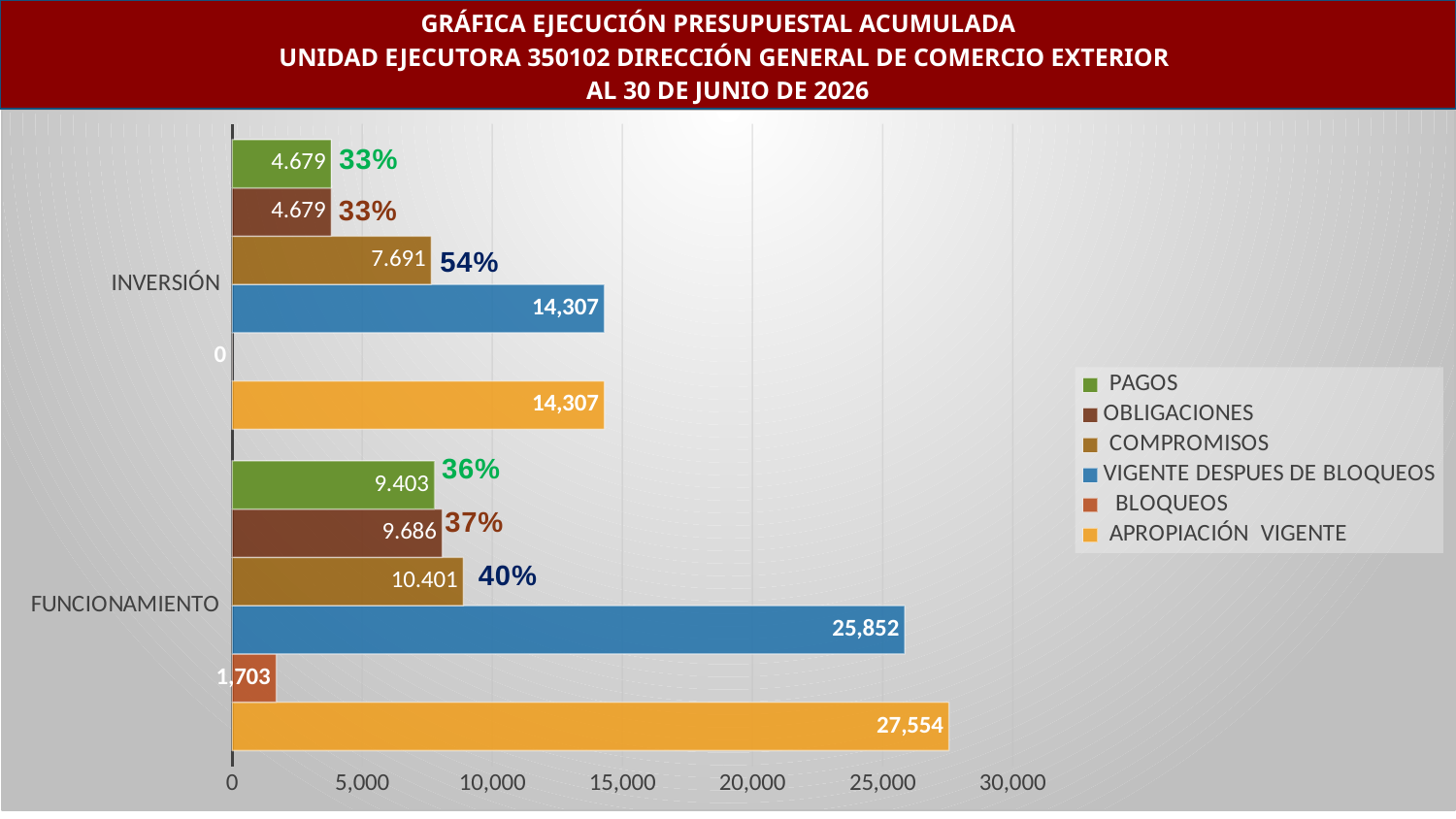
What is the value of COMPROMISOS for FUNCIONAMIENTO? 10.401 What kind of chart is shown on the slide? Bar chart How many series does the legend list? 6 Which series has the highest value for FUNCIONAMIENTO? APROPIACIÓN VIGENTE What is the value of BLOQUEOS for INVERSIÓN? 0 What percentage is shown next to the COMPROMISOS bar for INVERSIÓN? 54% What is the difference between BLOQUEOS for FUNCIONAMIENTO and BLOQUEOS for INVERSIÓN? 1,703 What is the value of VIGENTE DESPUES DE BLOQUEOS for INVERSIÓN? 14,307 How many categories are shown on the vertical axis? 2 What is the value of APROPIACIÓN VIGENTE for FUNCIONAMIENTO? 27,554 Is the value of VIGENTE DESPUES DE BLOQUEOS for FUNCIONAMIENTO greater or less than 25,000? greater Which category has the larger PAGOS value, INVERSIÓN or FUNCIONAMIENTO? FUNCIONAMIENTO